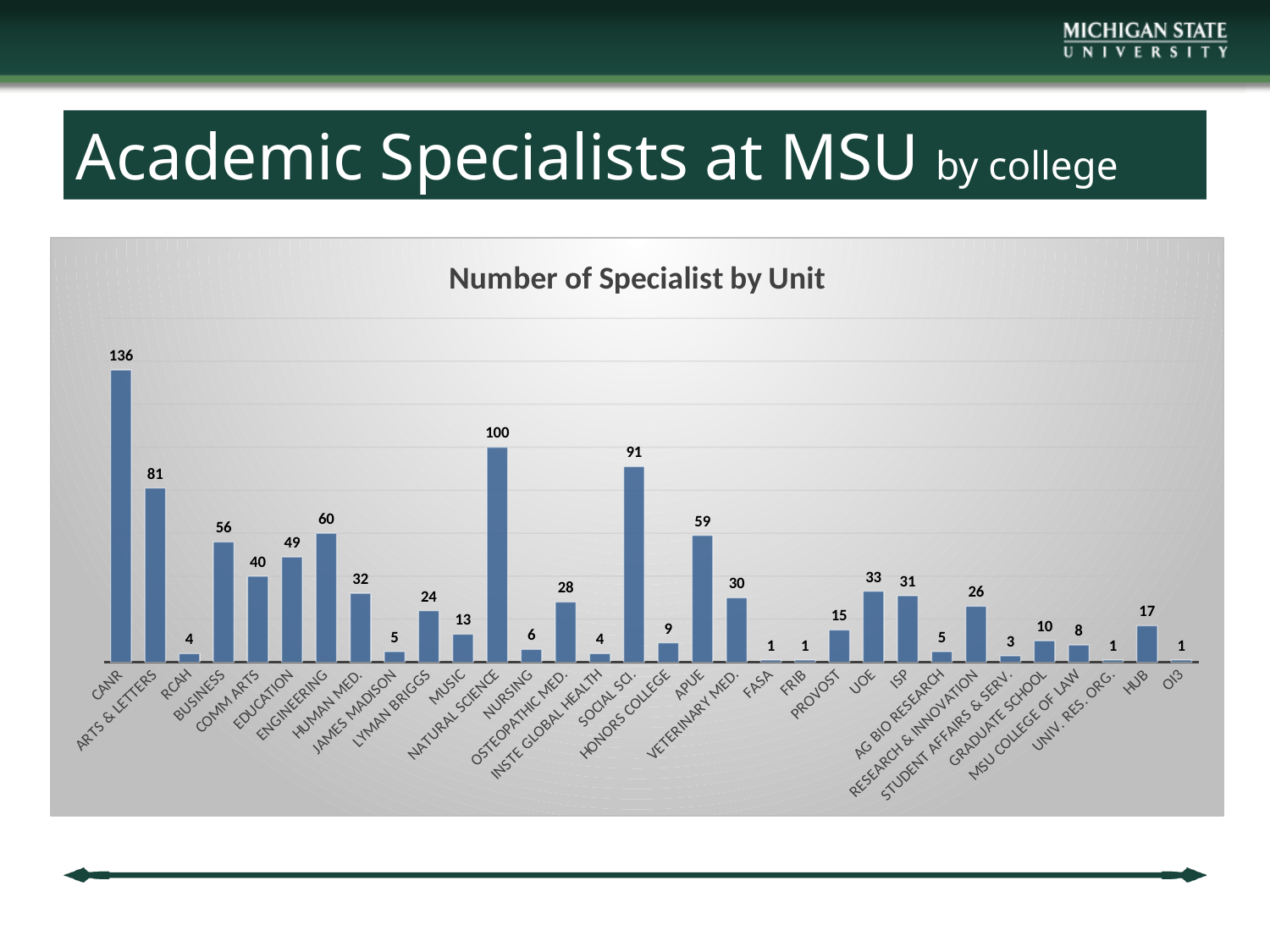
What is the difference between the values for CANR and ARTS & LETTERS? 55 Which has a larger value, ENGINEERING or APUE? ENGINEERING What is the title of the chart? Number of Specialist by Unit What is the difference between the values for NATURAL SCIENCE and SOCIAL SCI.? 9 How many units are shown on the x axis of the chart? 32 What is the value for SOCIAL SCI.? 91 Which has a larger value, UOE or ISP? UOE What is the value for NATURAL SCIENCE? 100 What kind of chart is shown on the slide? bar chart How many specialists does CANR have? 136 What is the value for HUB? 17 Which unit has the highest number of specialists? CANR